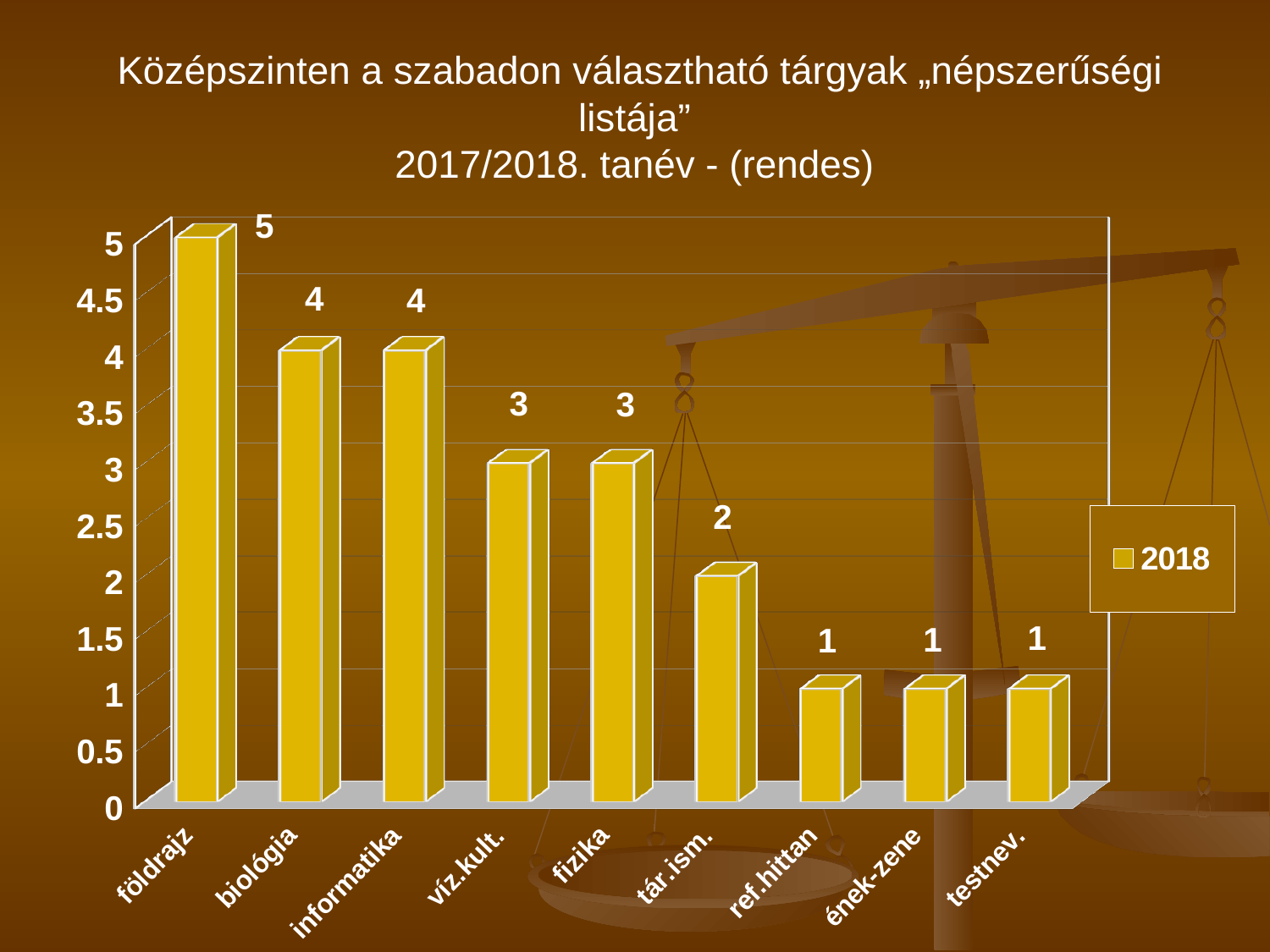
Which category has the highest value? földrajz What is the value for tár.ism.? 2 What kind of chart is shown on the slide? bar chart How many categories are shown on the x axis? 9 What is the value for víz.kult.? 3 What is the difference between the values for földrajz and biológia? 1 What is the difference between the values for informatika and ref.hittan? 3 What series name is shown in the legend? 2018 Which is larger, the value for fizika or the value for tár.ism.? fizika Is the value for biológia greater or less than 3? greater How many series does the legend list? 1 What is the value for földrajz? 5